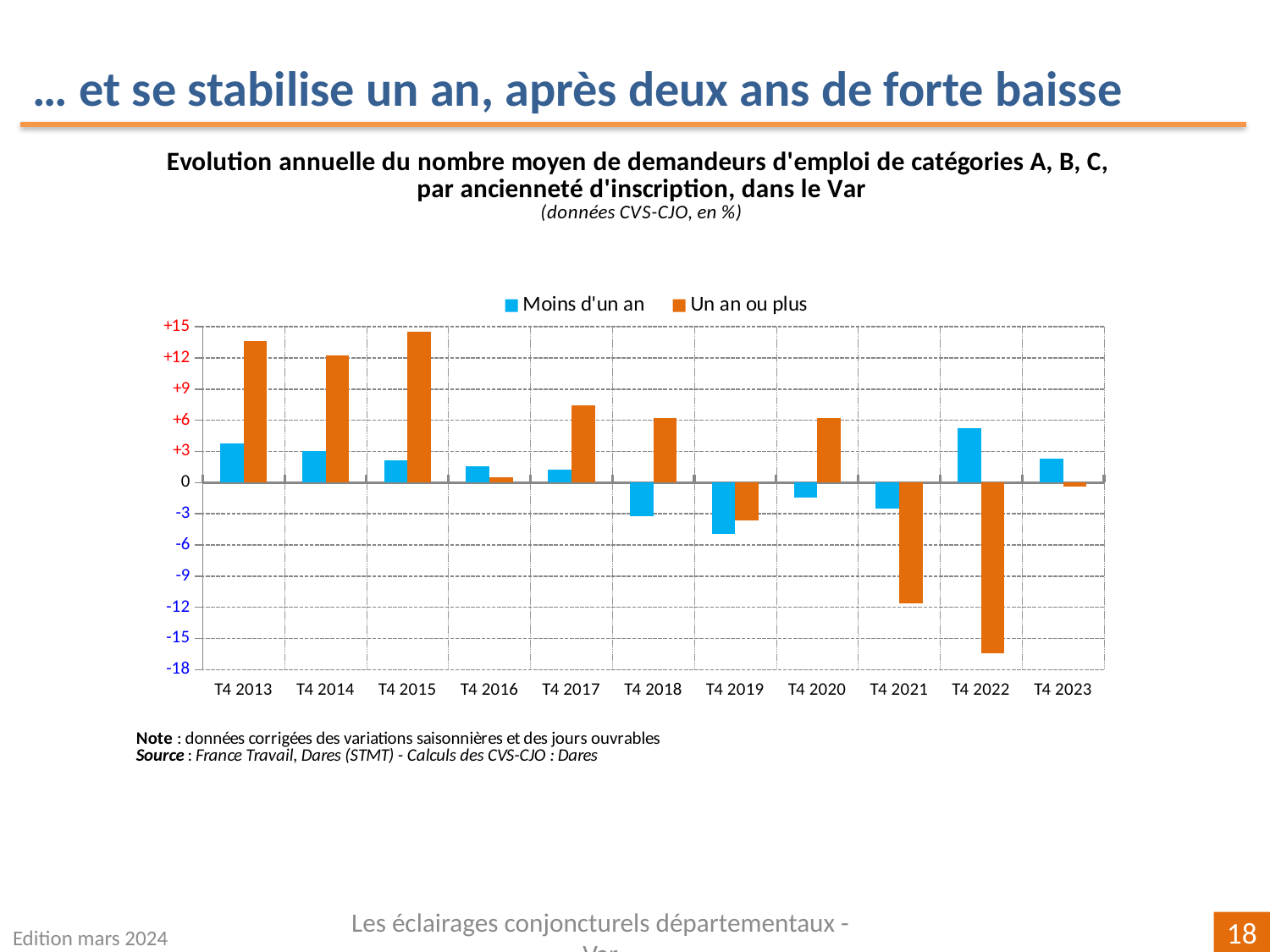
For the series 'Moins d'un an', which period has the lowest value? T4 2019 What kind of chart is shown on the slide? bar chart Is the value for 'Moins d'un an' in T4 2022 greater or less than +3? greater Is the value for 'Un an ou plus' in T4 2022 greater or less than -15? less For the series 'Un an ou plus', which period has the lowest value? T4 2022 For the series 'Moins d'un an', which period has the highest value? T4 2022 How many series does the legend list? 2 For the series 'Un an ou plus', which period has the highest value? T4 2015 Is the value for 'Un an ou plus' in T4 2021 greater or less than -9? less Which colour represents the series 'Un an ou plus' in the legend? orange In T4 2018, which series has the larger value, 'Moins d'un an' or 'Un an ou plus'? Un an ou plus How many periods (categories) are shown on the x axis? 11